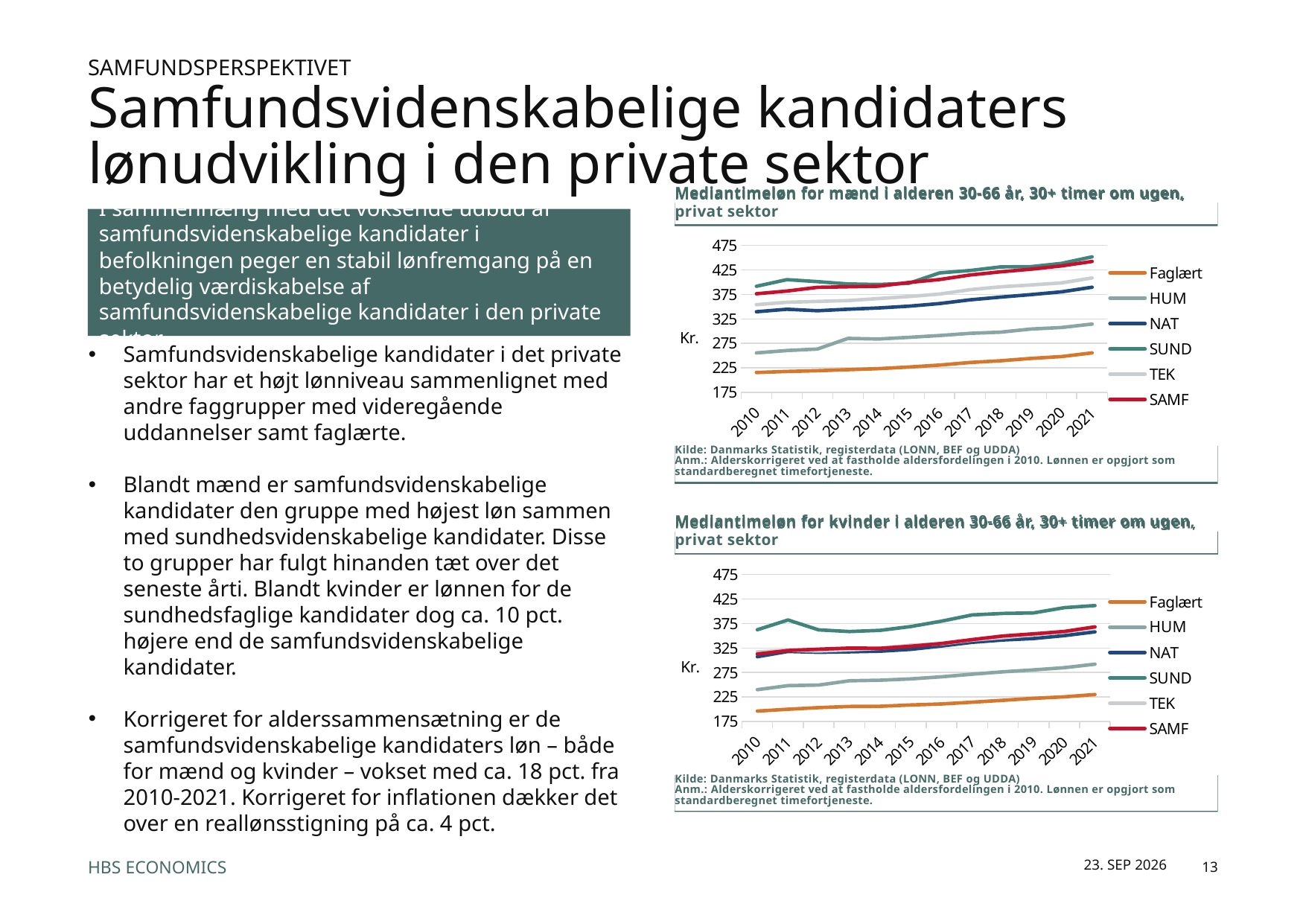
What unit label is shown on the y axis of the top chart (Mediantimeløn for mænd)? Kr. How many series does the legend of the bottom chart (Mediantimeløn for kvinder) list? 6 In the bottom chart (Mediantimeløn for kvinder), which is larger in 2021: SUND or NAT? SUND In the bottom chart (Mediantimeløn for kvinder), is the value for SUND in 2017 greater or less than 375? greater In the top chart (Mediantimeløn for mænd), does the Faglært series rise or fall from 2010 to 2021? rise In the top chart (Mediantimeløn for mænd), is the value for SUND in 2021 greater or less than 425? greater In the bottom chart (Mediantimeløn for kvinder), which series is highest in 2021? SUND How many years are shown on the x axis of the top chart (Mediantimeløn for mænd)? 12 In the top chart (Mediantimeløn for mænd), is the value for Faglært in 2021 greater or less than 225? greater What kind of chart is the top chart, 'Mediantimeløn for mænd i alderen 30-66 år, 30+ timer om ugen, privat sektor'? line chart In the top chart (Mediantimeløn for mænd), which series has the lowest values across the whole period? Faglært